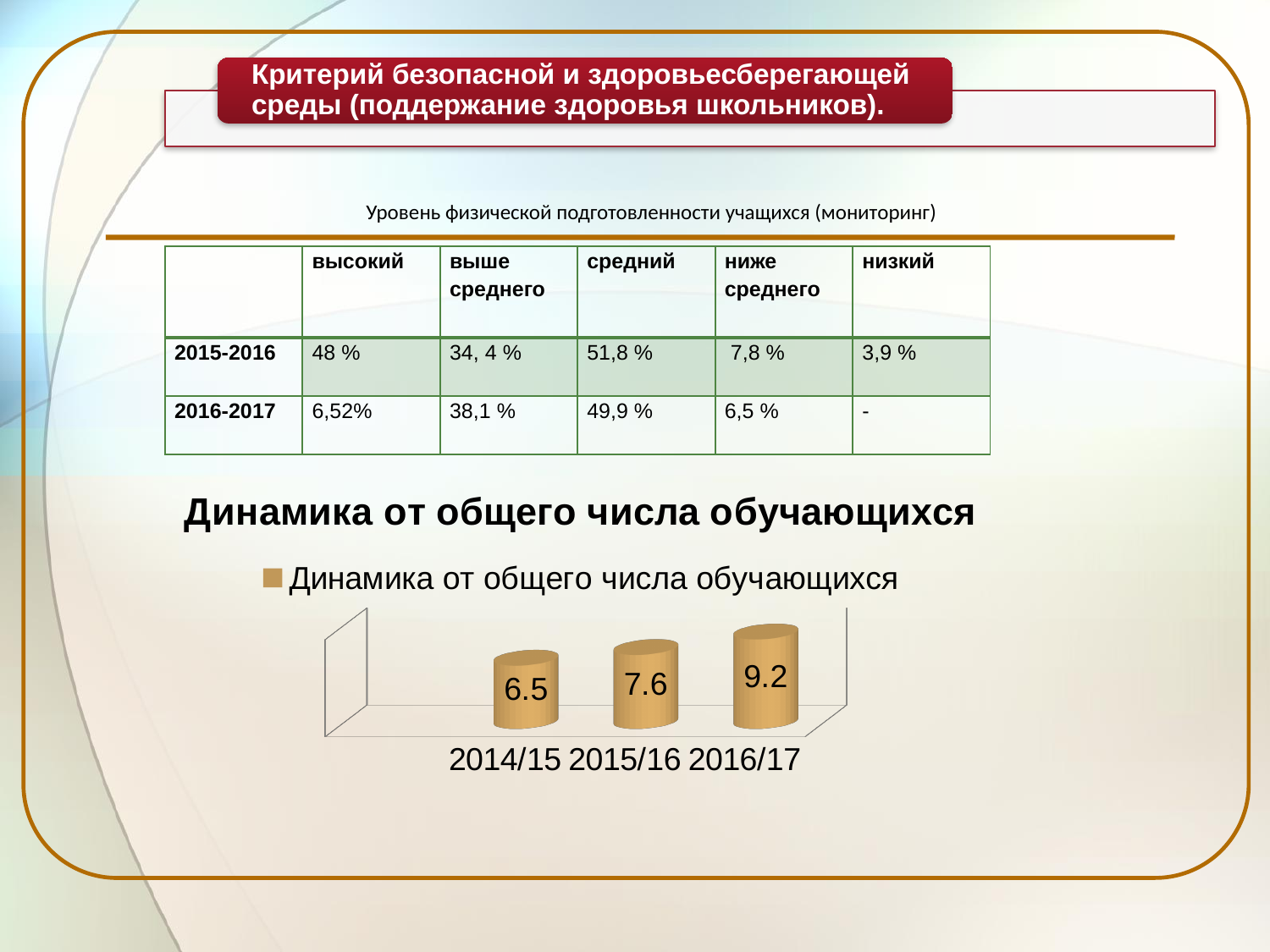
What is the value for 2015/16 in the chart? 7.6 What kind of chart is shown on the slide? bar chart What is the value for 2014/15 in the chart? 6.5 Which category has the lowest value in the chart? 2014/15 Which category has the highest value in the chart? 2016/17 What is the value for 2016/17 in the chart? 9.2 Which is larger, the value for 2015/16 or the value for 2016/17? 2016/17 What is the difference between the values for 2016/17 and 2014/15? 2.7 Do the values rise or fall from 2014/15 to 2016/17? rise How many categories are shown on the x axis of the chart? 3 What is the difference between the values for 2015/16 and 2014/15? 1.1 How many series does the chart legend list? 1